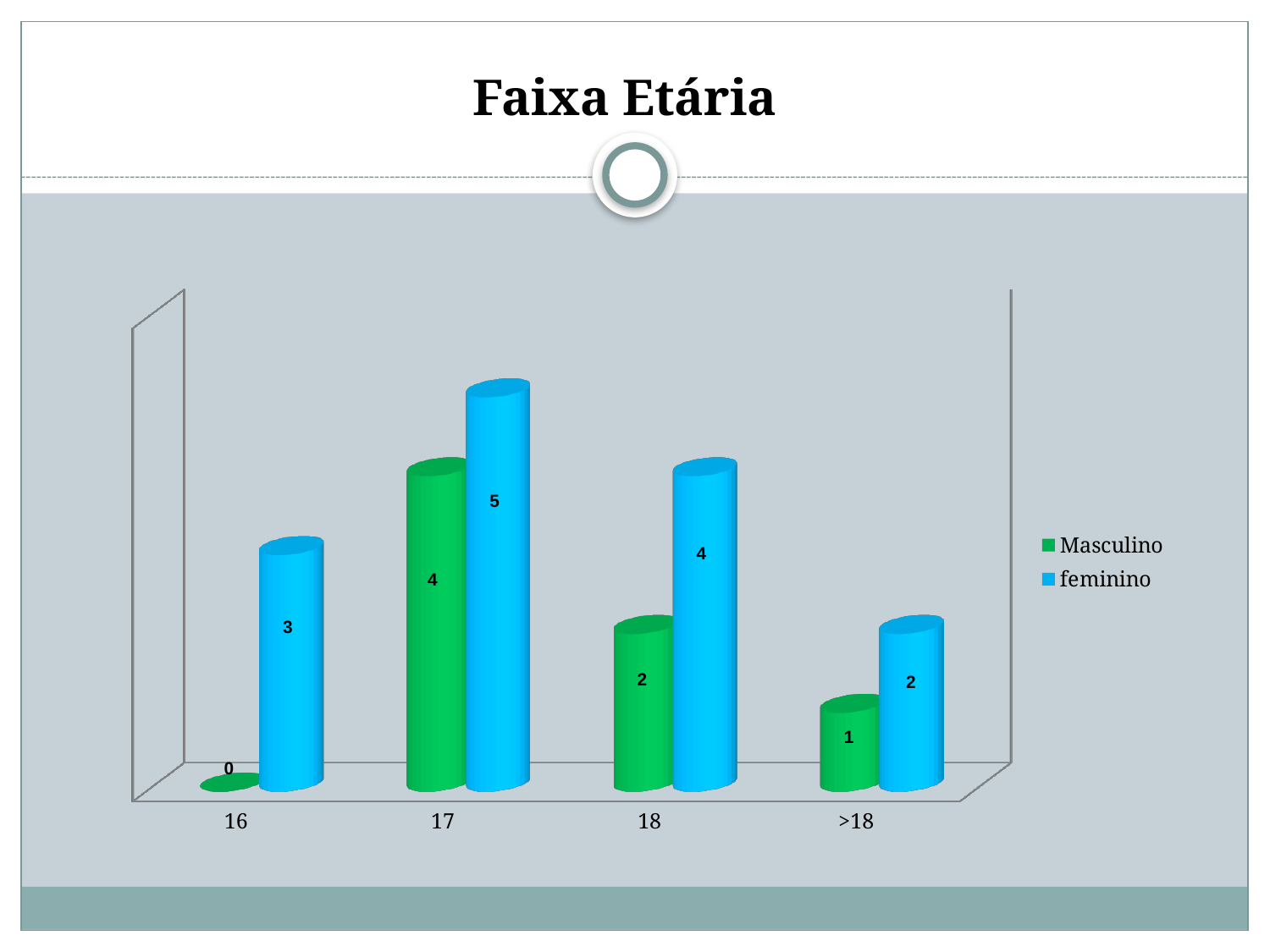
What kind of chart is shown on the slide? bar chart Which is larger at age 17, the Masculino value or the feminino value? feminino How many series does the legend list? 2 What is the title of the chart? Faixa Etária What is the value for Masculino at age 16? 0 What is the value for Masculino at age 17? 4 How many age categories are shown on the x axis? 4 Which age category has the highest feminino value? 17 What is the value for feminino at >18? 2 Which age category has the lowest Masculino value? 16 What is the value for feminino at age 16? 3 What is the difference between the feminino and Masculino values at age 18? 2